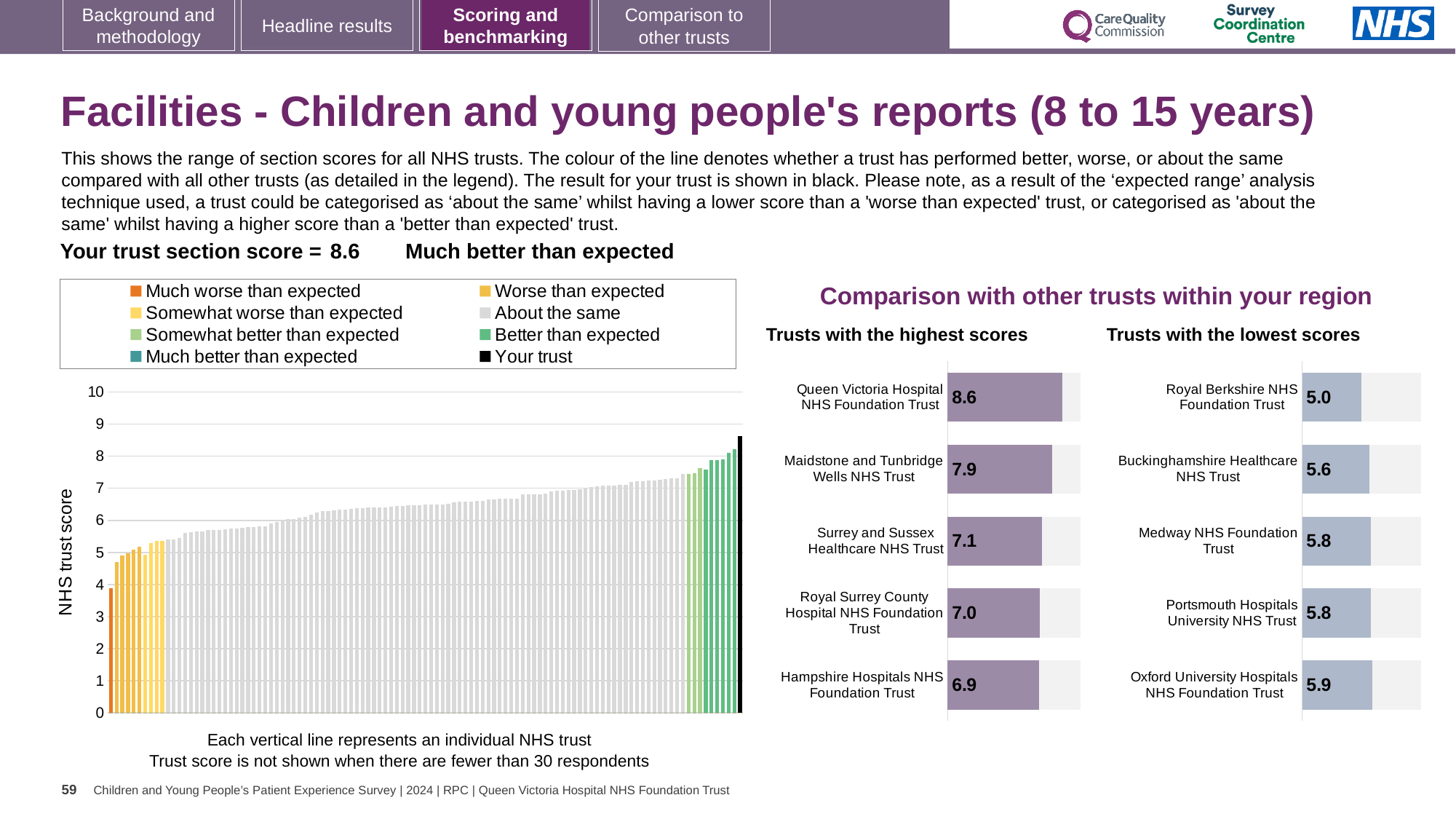
In the 'Trusts with the lowest scores' chart, what is the score for Oxford University Hospitals NHS Foundation Trust? 5.9 In the 'Trusts with the highest scores' chart, what is the score for Surrey and Sussex Healthcare NHS Trust? 7.1 Which has a higher score: Royal Surrey County Hospital NHS Foundation Trust in the highest-scores chart or Buckinghamshire Healthcare NHS Trust in the lowest-scores chart? Royal Surrey County Hospital NHS Foundation Trust In the 'Trusts with the highest scores' chart, what is the difference between the scores of Queen Victoria Hospital NHS Foundation Trust and Maidstone and Tunbridge Wells NHS Trust? 0.7 In the left-hand 'NHS trust score' chart, do the values rise or fall from left to right along the x axis? rise In the 'Trusts with the lowest scores' chart, what is the score for Royal Berkshire NHS Foundation Trust? 5.0 In the 'Trusts with the highest scores' chart, what is the score for Queen Victoria Hospital NHS Foundation Trust? 8.6 In the 'Trusts with the lowest scores' chart, what is the difference between the scores of Oxford University Hospitals NHS Foundation Trust and Royal Berkshire NHS Foundation Trust? 0.9 How many trusts are shown in the 'Trusts with the lowest scores' chart? 5 In the 'Trusts with the highest scores' chart, which trust has the lowest score? Hampshire Hospitals NHS Foundation Trust In the 'Trusts with the lowest scores' chart, which trust has the highest score? Oxford University Hospitals NHS Foundation Trust How many entries does the legend of the left-hand 'NHS trust score' chart list? 8